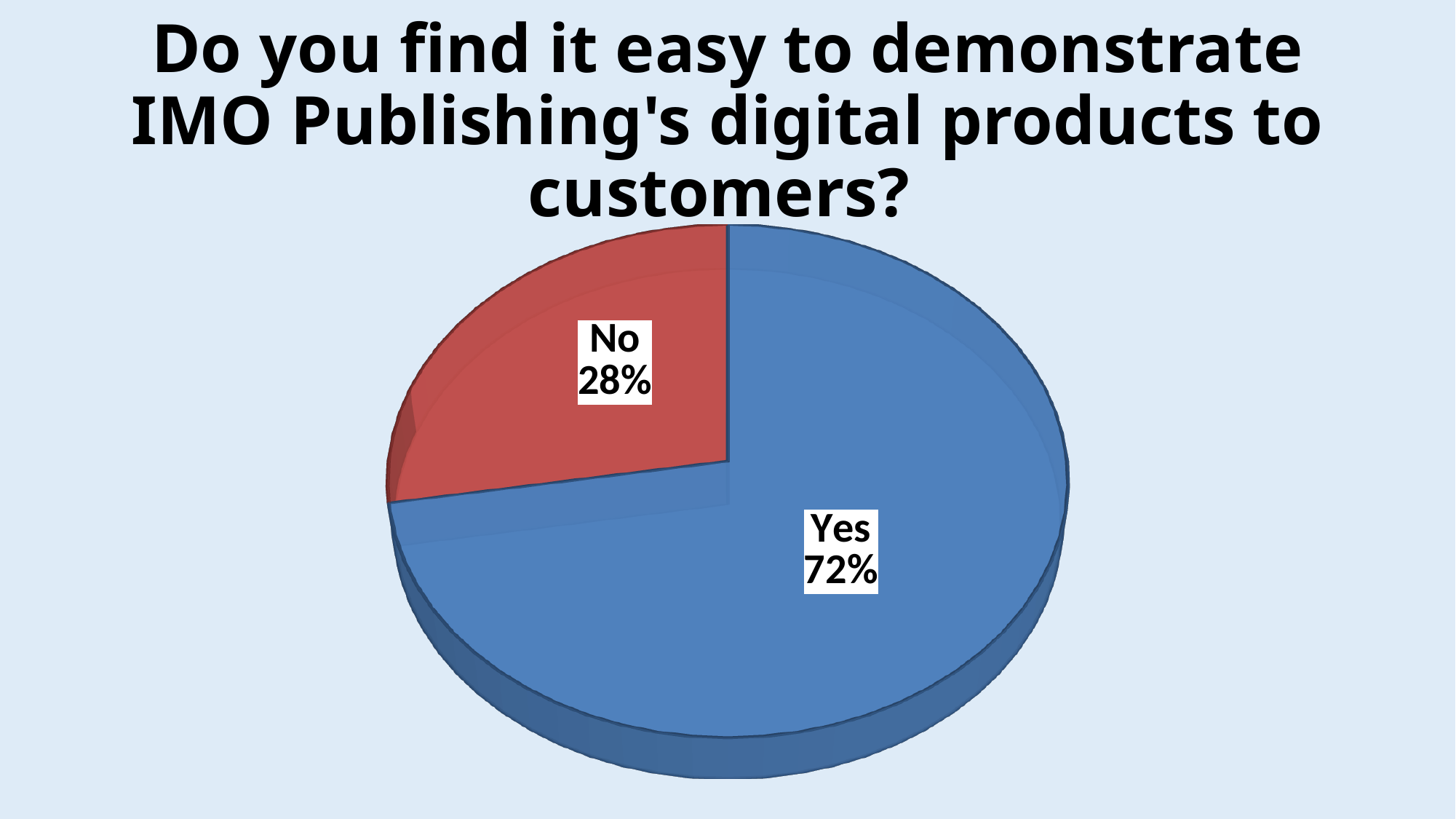
Is the Yes share greater or less than 50%? greater Which response has the largest share of the pie? Yes What share of the pie does the Yes slice represent? 72% What colour is the No slice? Red What is the difference in percentage points between the Yes and No shares? 44 What percentage of respondents answered No? 28% What percentage of respondents answered Yes? 72% What is the title of the chart? Do you find it easy to demonstrate IMO Publishing's digital products to customers? How many slices does the pie chart have? 2 What kind of chart is shown on the slide? Pie chart Which is larger, the Yes share or the No share? Yes Which response has the smallest share of the pie? No